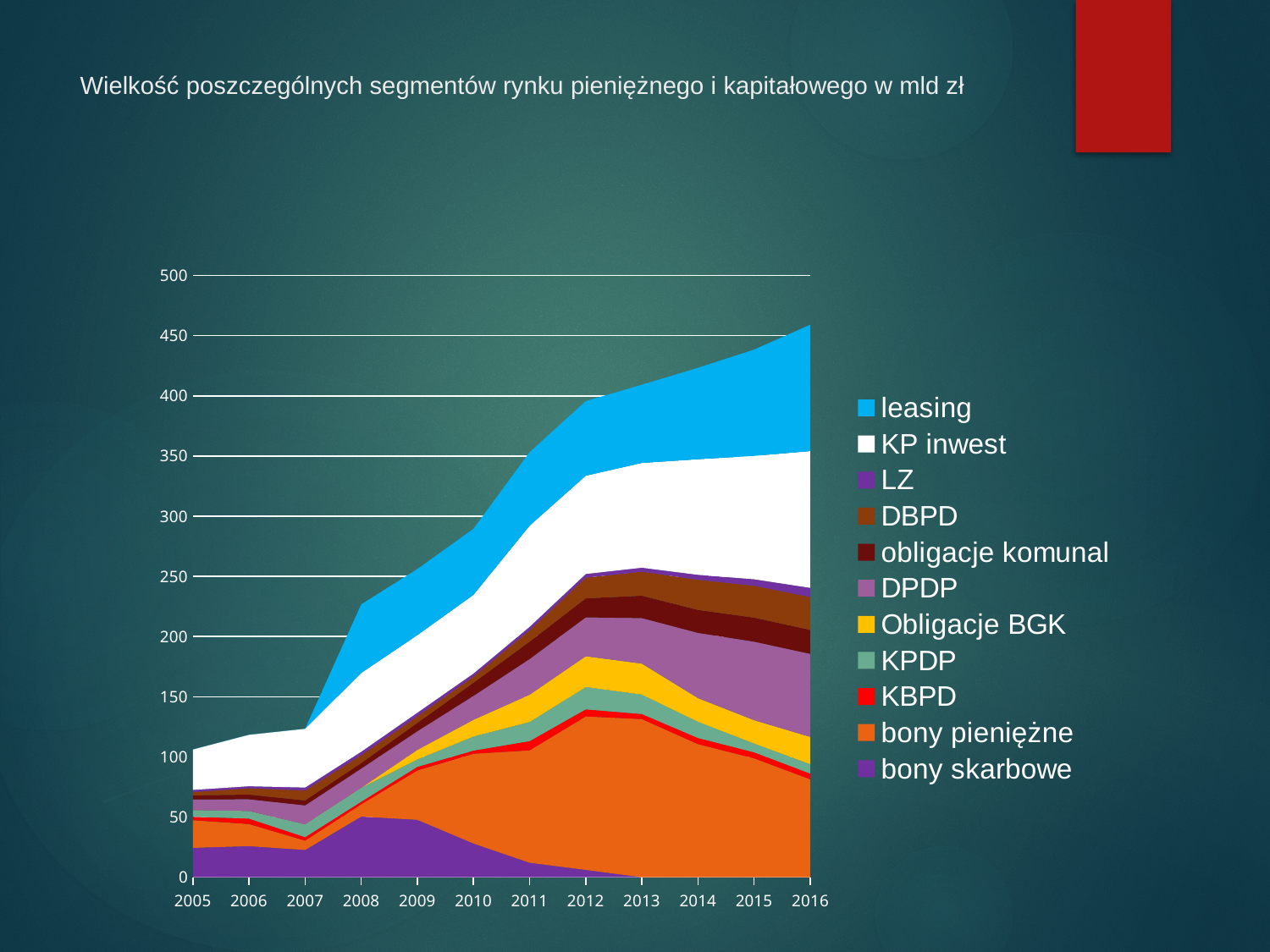
Is the total stacked value for 2010 greater or less than 300? less Is the total stacked value for 2008 greater or less than 200? greater Which year has the lowest total stacked value? 2005 Is the total stacked value for 2016 greater or less than 400? greater How many series does the legend list? 11 Does the total stacked value generally rise or fall from 2005 to 2016? rise Which year has the highest total stacked value? 2016 What is the title of the slide above the chart? Wielkość poszczególnych segmentów rynku pieniężnego i kapitałowego w mld zł What kind of chart is shown on the slide? stacked area chart Which year has the larger total stacked value, 2007 or 2008? 2008 How many years are plotted along the x axis? 12 Which series is listed first (at the top) in the legend? leasing